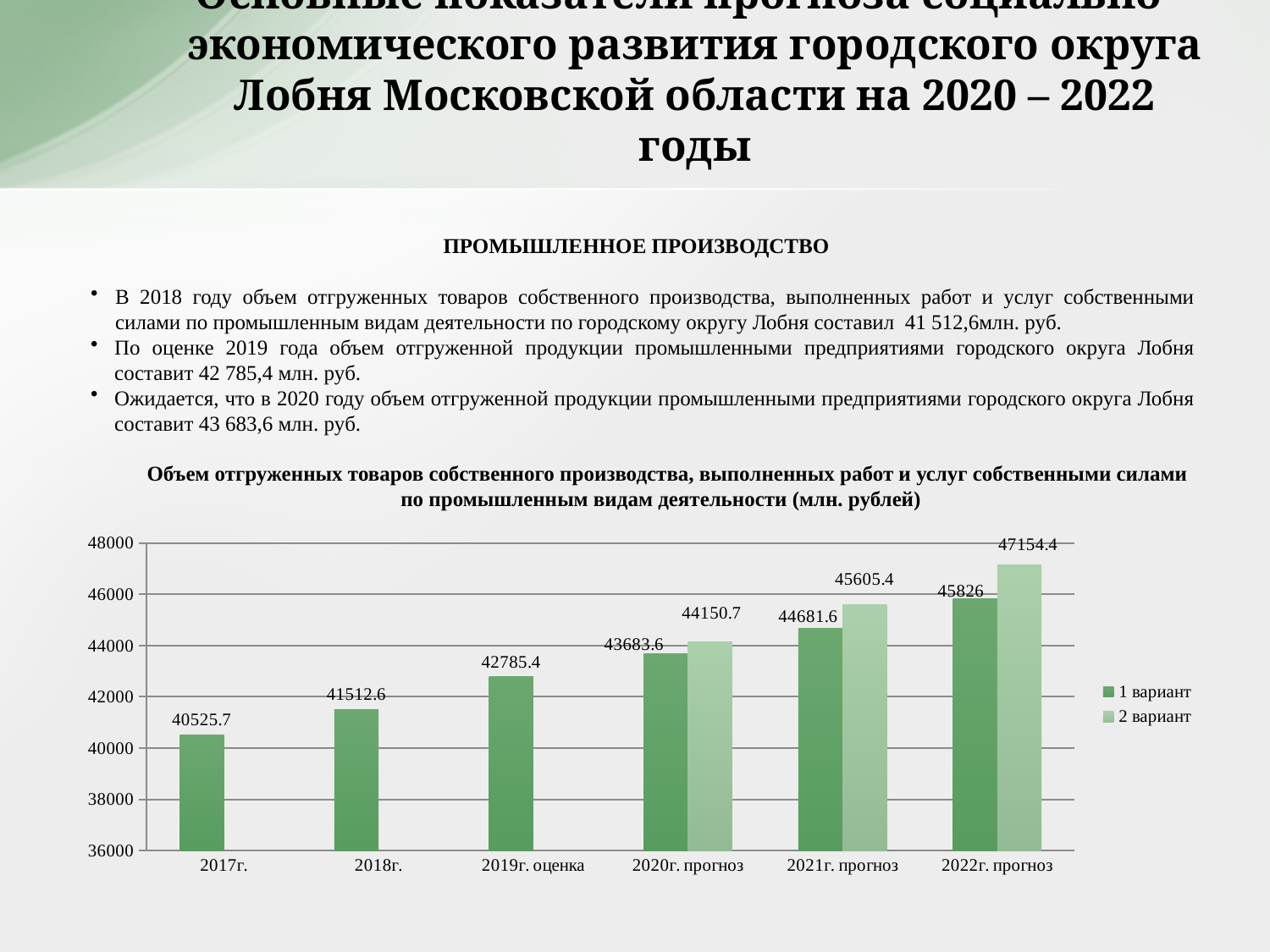
Which category has the lowest value for 1 вариант? 2017г. Which category has the highest value for 1 вариант? 2022г. прогноз What kind of chart is shown? bar chart Which is larger: 1 вариант in 2021г. прогноз or 2 вариант in 2020г. прогноз? 1 вариант in 2021г. прогноз Do the values for 1 вариант rise or fall from 2017г. to 2022г. прогноз? rise What is the difference between 2 вариант and 1 вариант in 2022г. прогноз? 1328.4 What is the value for 1 вариант in 2020г. прогноз? 43683.6 How many categories are shown on the x axis? 6 What is the value for 1 вариант in 2017г.? 40525.7 How many series does the legend list? 2 What is the value for 2 вариант in 2021г. прогноз? 45605.4 What is the value for 2 вариант in 2022г. прогноз? 47154.4